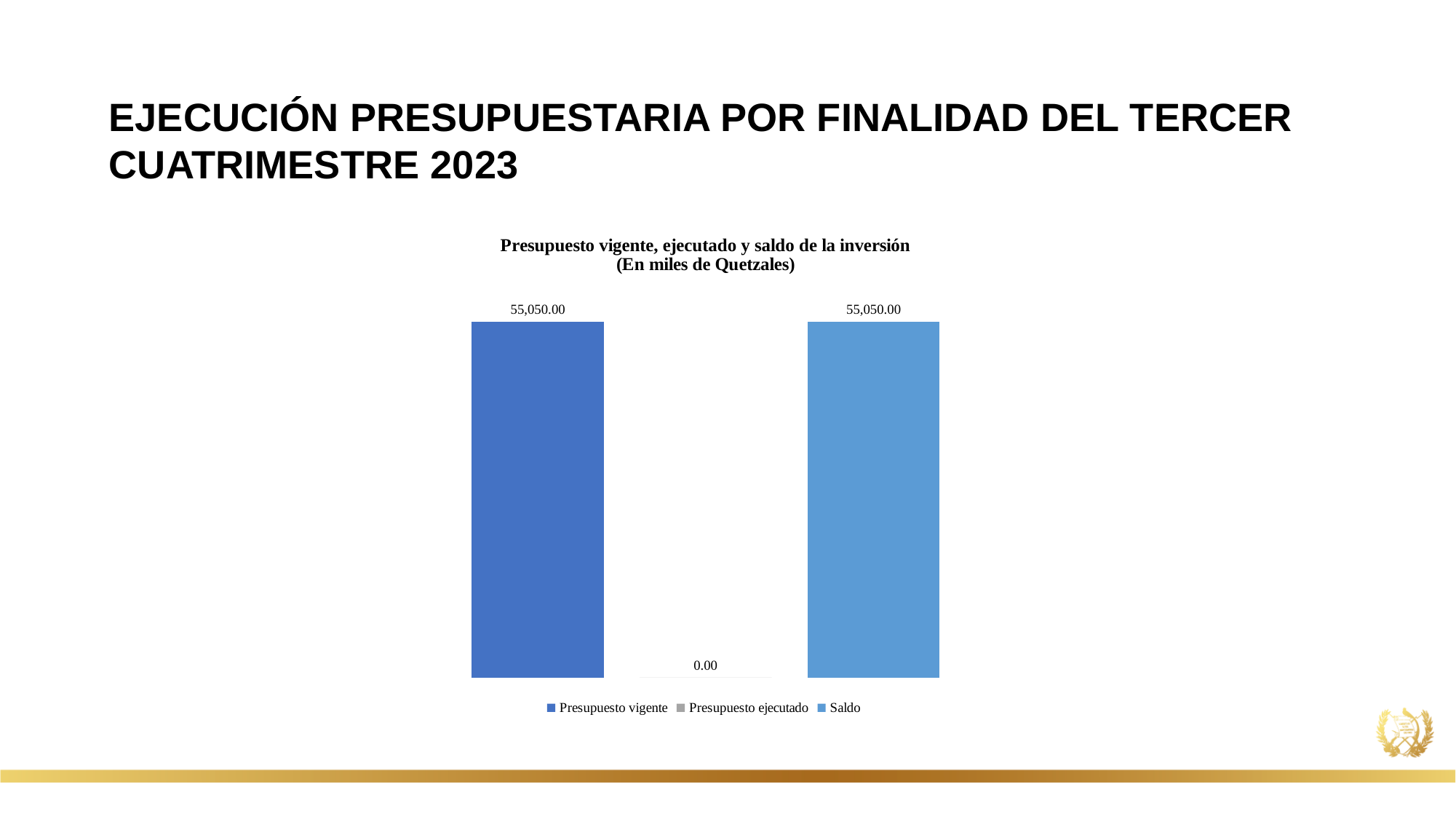
In what units are the chart values expressed? Miles de Quetzales Which is larger, Saldo or Presupuesto ejecutado? Saldo What is the value for Saldo? 55,050.00 How many bars are plotted in the chart? 3 What is the value for Presupuesto vigente? 55,050.00 How many series does the legend list? 3 What is the difference between Presupuesto vigente and Presupuesto ejecutado? 55,050.00 What is the value for Presupuesto ejecutado? 0.00 Which series has the lowest value? Presupuesto ejecutado What kind of chart is shown on the slide? Bar chart What is the title of the chart? Presupuesto vigente, ejecutado y saldo de la inversión (En miles de Quetzales) What is the difference between Saldo and Presupuesto vigente? 0.00